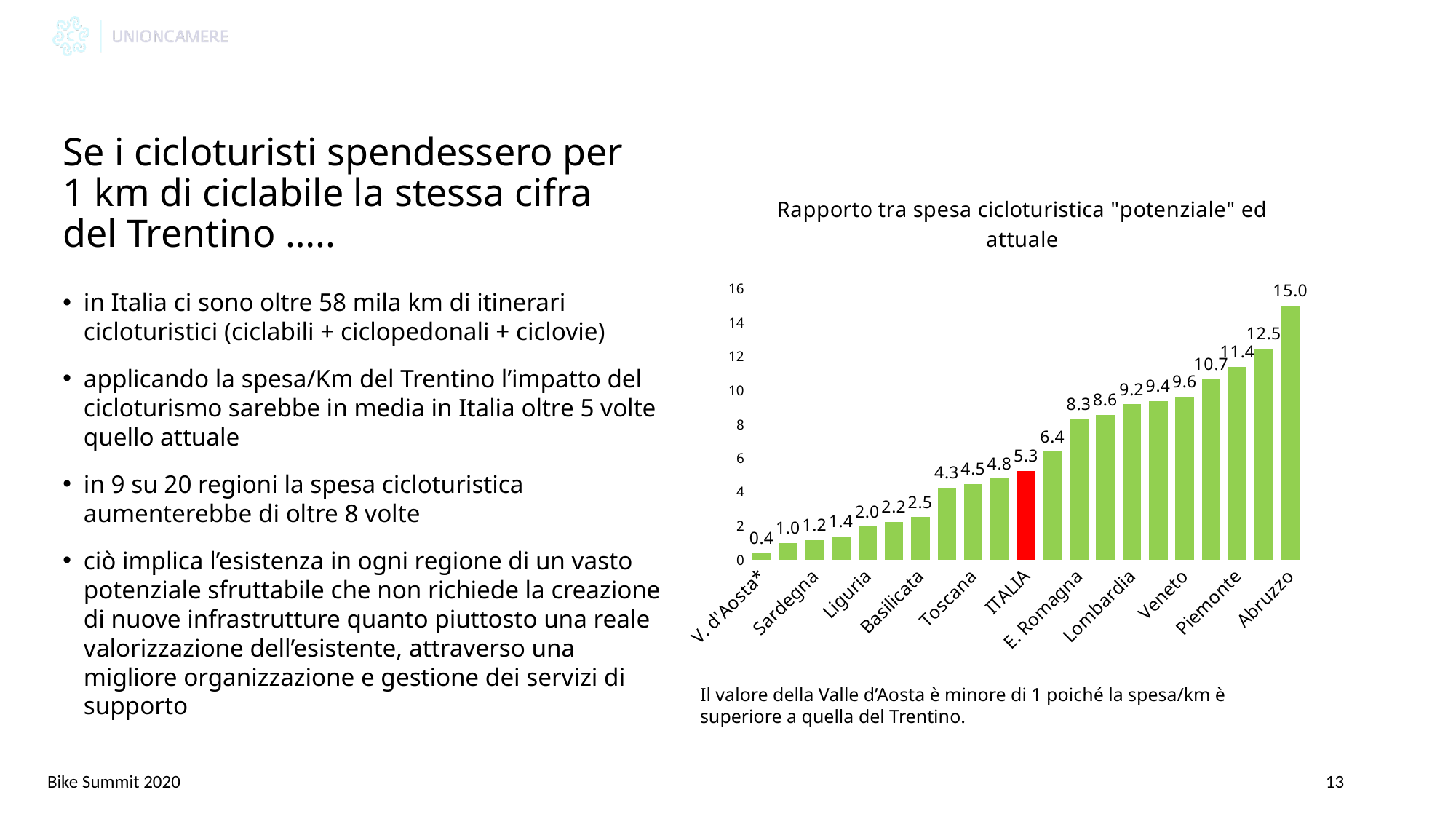
What is the difference between the values for Abruzzo and ITALIA? 9.7 What is the value for Piemonte? 11.4 Do the values rise or fall from left to right along the x axis? rise Which category has the highest value? Abruzzo Which has a larger value, Piemonte or Veneto? Piemonte What is the value for Abruzzo? 15.0 What is the title of the chart? Rapporto tra spesa cicloturistica "potenziale" ed attuale What is the value for V. d'Aosta*? 0.4 Which category is shown with a red bar? ITALIA What type of chart is shown on the slide? bar chart Which category has the lowest value? V. d'Aosta* What is the value for ITALIA? 5.3